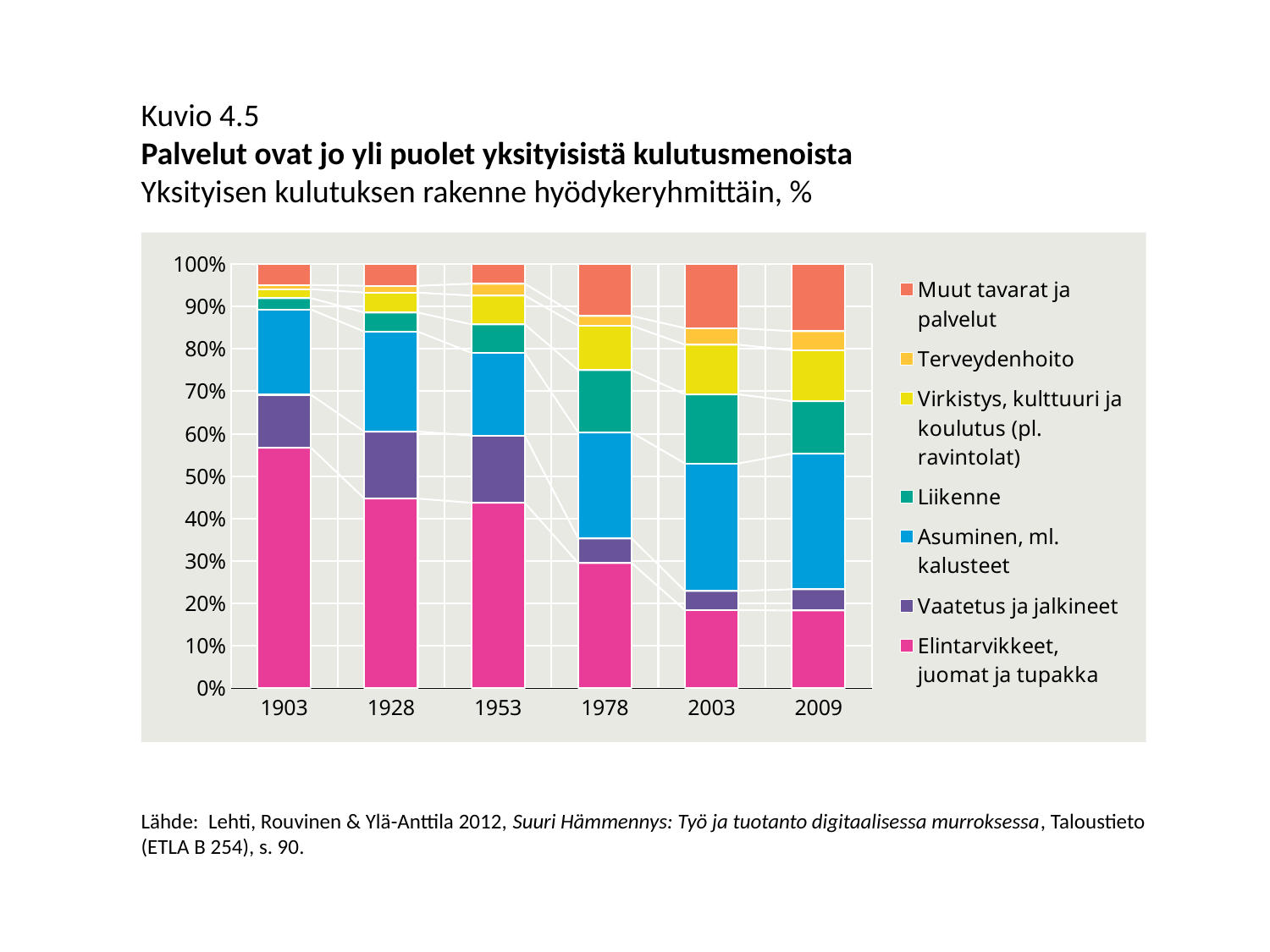
Which is larger: the share of Elintarvikkeet, juomat ja tupakka in 1903 or in 1978? 1903 What is the total of the stacked bar for 1978? 100% Which series is listed first (at the top) in the chart's legend? Muut tavarat ja palvelut How many years are shown on the x axis of the chart? 6 What is the figure number given above the chart title? Kuvio 4.5 How many series does the chart's legend list? 7 Is the share of Elintarvikkeet, juomat ja tupakka in 2009 greater or less than 30%? less Which year has the largest share for Elintarvikkeet, juomat ja tupakka? 1903 Is the share of Elintarvikkeet, juomat ja tupakka in 1903 greater or less than 50%? greater Is the share of Elintarvikkeet, juomat ja tupakka in 1928 greater or less than 50%? less Does the share of Elintarvikkeet, juomat ja tupakka rise or fall from 1903 to 2009? Fall What kind of chart is shown on the slide? Stacked bar chart